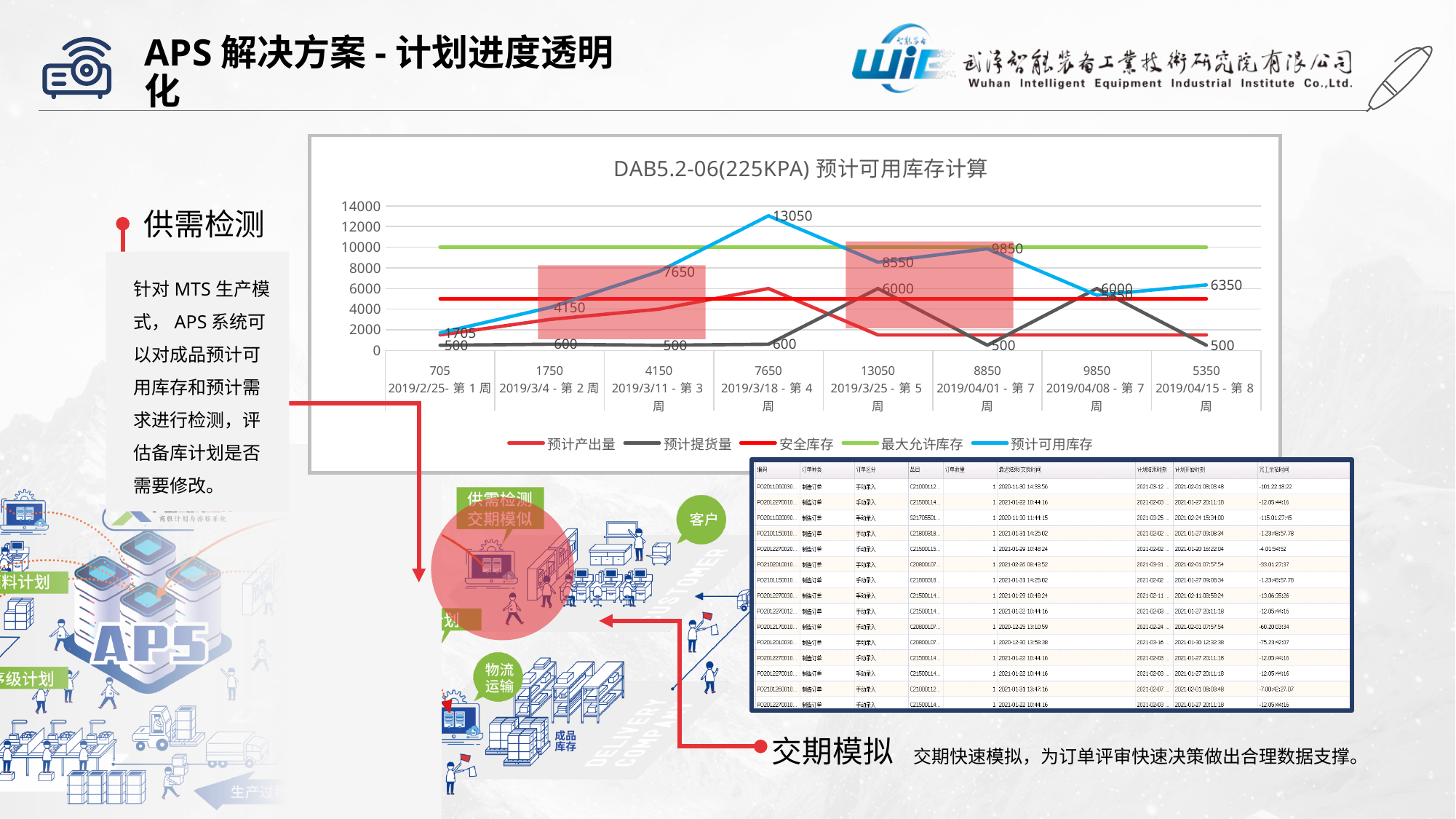
What is the value of the 最大允许库存 line? 10000 How many series does the chart legend list? 5 How many weekly categories are shown on the x axis? 8 What is the title of the chart? DAB5.2-06(225KPA) 预计可用库存计算 What type of chart is shown on the slide? line chart What is the lowest labelled value of the 预计可用库存 series? 1705 What is the difference between the highest (13050) and lowest (1705) labelled values of 预计可用库存? 11345 Which line is higher, 最大允许库存 or 安全库存? 最大允许库存 What is the last labelled value of the 预计可用库存 series at the right end of the chart? 6350 Is the value of the 安全库存 line greater or less than 4000? greater Does the 最大允许库存 line rise, fall, or stay flat across the x axis? stays flat What is the highest labelled value of the 预计可用库存 series? 13050